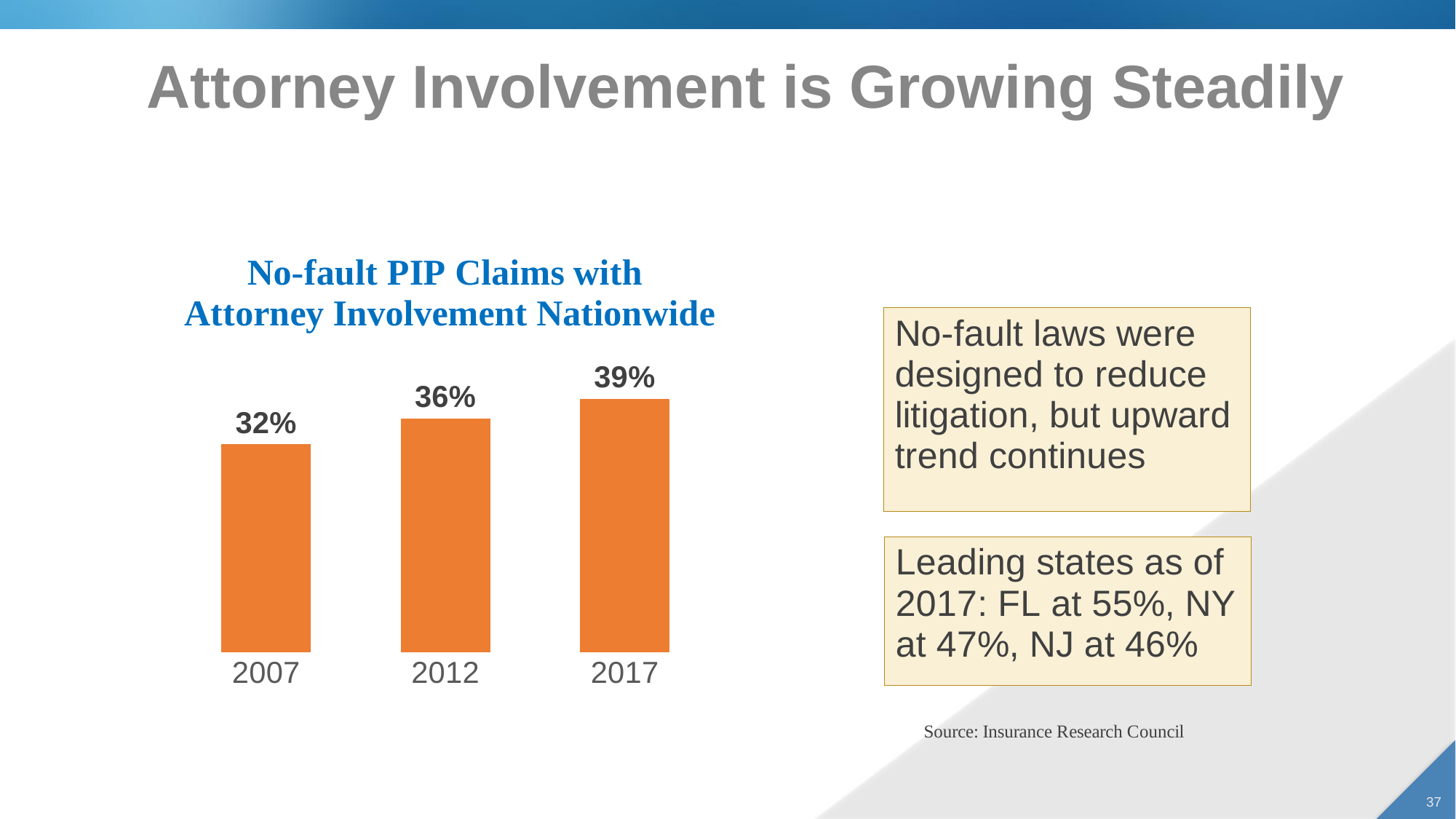
Which is larger, the value for 2012 or the value for 2017? 2017 What is the value for 2017? 39% What is the value for 2007? 32% What is the difference between the values for 2012 and 2007? 4% What kind of chart is this? Bar chart Which year has the lowest value? 2007 What is the difference between the values for 2017 and 2007? 7% What is the value for 2012? 36% Which year has the highest value? 2017 How many years are shown on the chart? 3 Do the values rise or fall from 2007 to 2017? Rise What is the title of the chart? No-fault PIP Claims with Attorney Involvement Nationwide